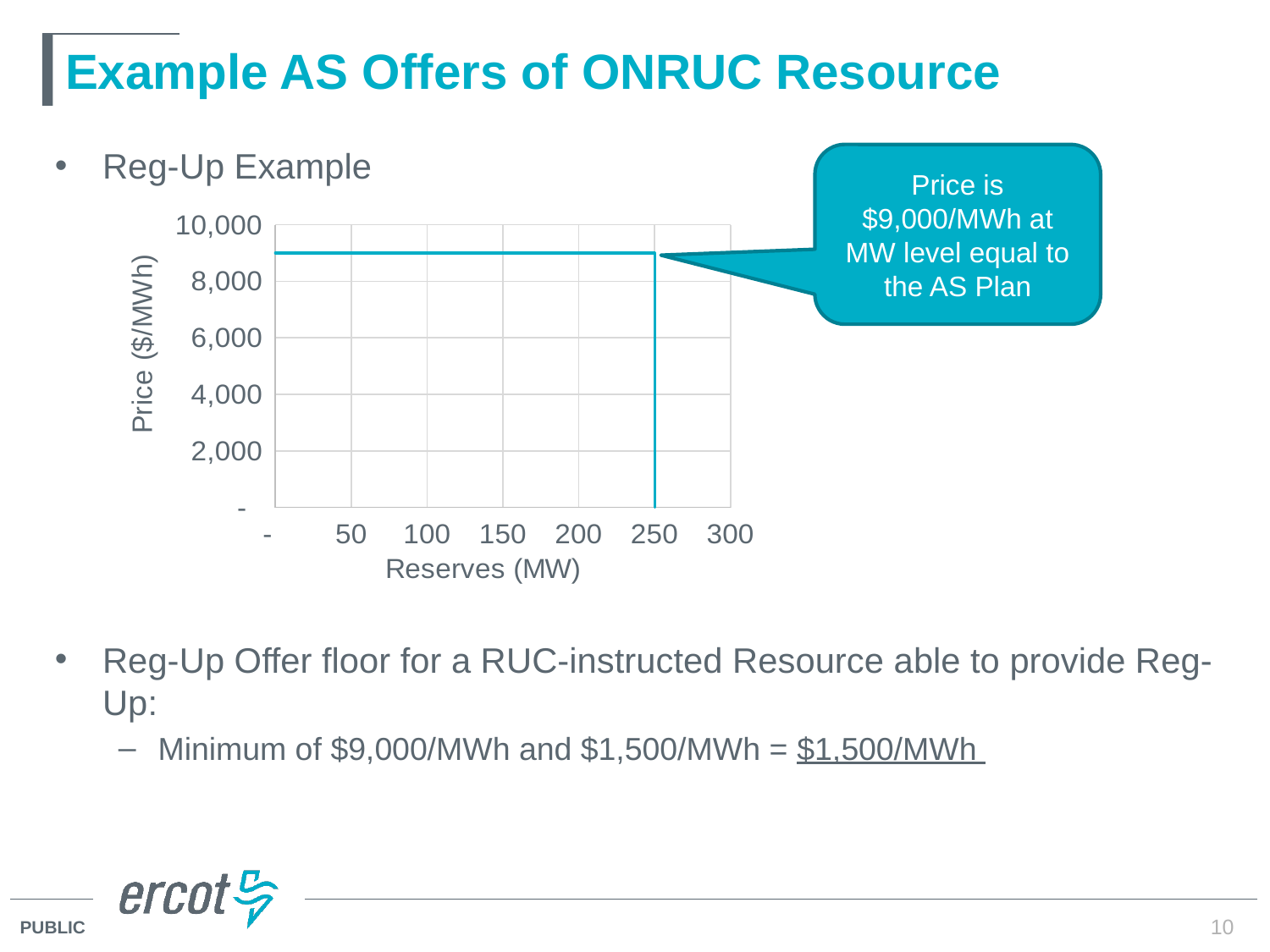
Does the price in the Reg-Up Example chart rise, fall, or stay flat between 0 and 250 MW of reserves? stay flat What is the highest value shown on the x axis of the Reg-Up Example chart? 300 At what reserve level (MW) does the offer curve drop vertically in the Reg-Up Example chart? 250 What kind of chart is shown under "Reg-Up Example"? line chart What is the label of the x axis of the Reg-Up Example chart? Reserves (MW) What is the highest value shown on the y axis of the Reg-Up Example chart? 10,000 Is the price at 200 MW of reserves in the Reg-Up Example chart greater or less than 10,000? less How many labelled tick marks are on the x axis of the Reg-Up Example chart? 7 Is the price at 50 MW of reserves in the Reg-Up Example chart greater or less than 6,000? greater What is the label of the y axis of the Reg-Up Example chart? Price ($/MWh) According to the callout, what is the price of the Reg-Up offer at the MW level equal to the AS Plan? $9,000/MWh Is the price at 100 MW of reserves in the Reg-Up Example chart greater or less than 8,000? greater